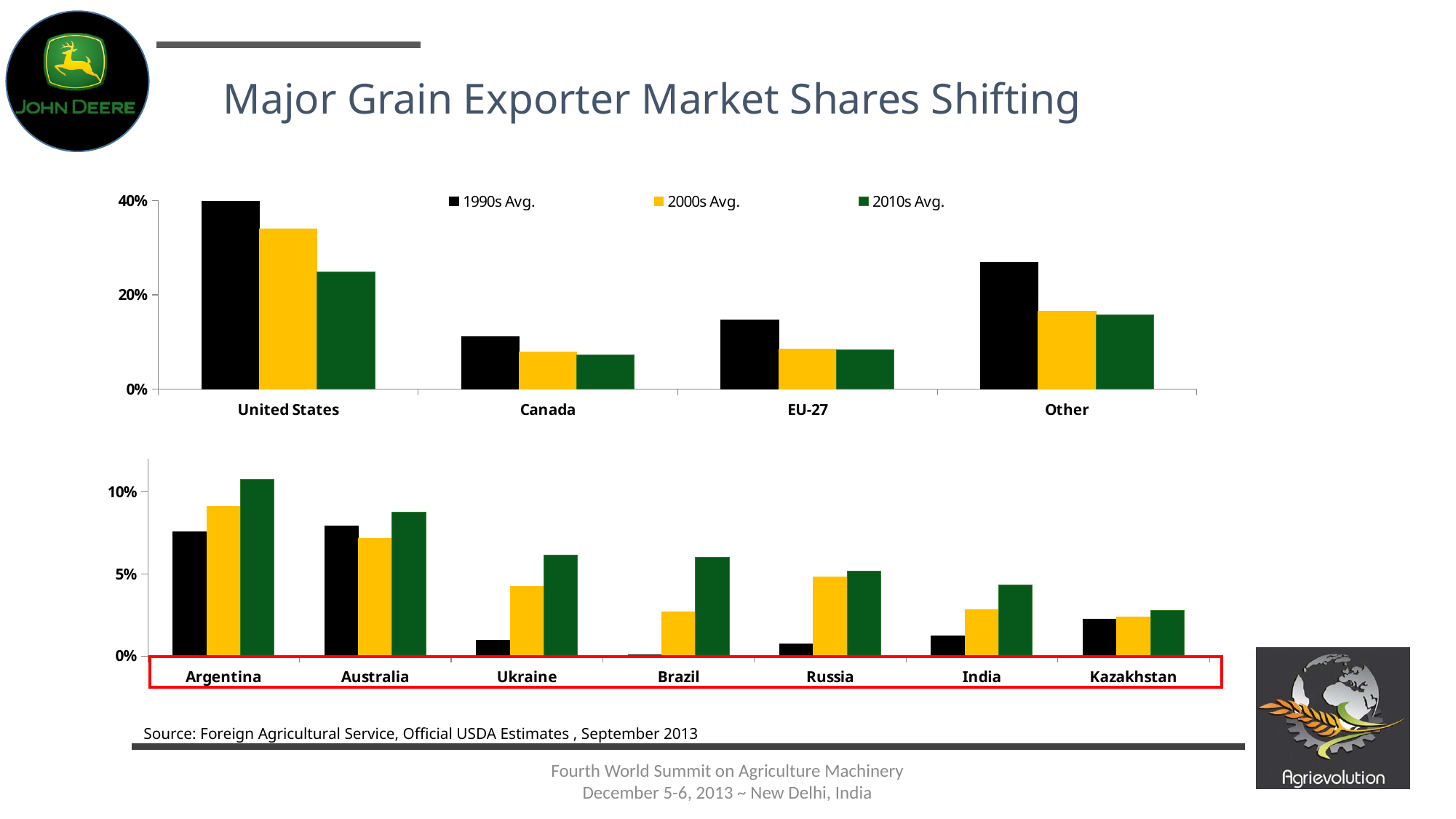
On the top chart, do the United States values rise or fall from the 1990s Avg. to the 2010s Avg.? fall On the bottom chart, which country has the lowest 1990s Avg. value? Brazil On the top chart, is the 1990s Avg. value for Other greater or less than 20%? greater What kind of chart is the top chart on the slide? bar chart How many countries or regions are shown on the bottom chart? 7 On the top chart, which category has the highest 1990s Avg. value? United States On the bottom chart, is the 2010s Avg. value for Ukraine greater or less than 5%? greater On the bottom chart, which country has the highest 2010s Avg. value? Argentina On the top chart, which category has the lowest 2010s Avg. value? Canada How many categories are shown on the top chart? 4 How many series does the legend list for the charts? 3 On the bottom chart, which is larger for Australia: the 1990s Avg. or the 2000s Avg.? 1990s Avg.